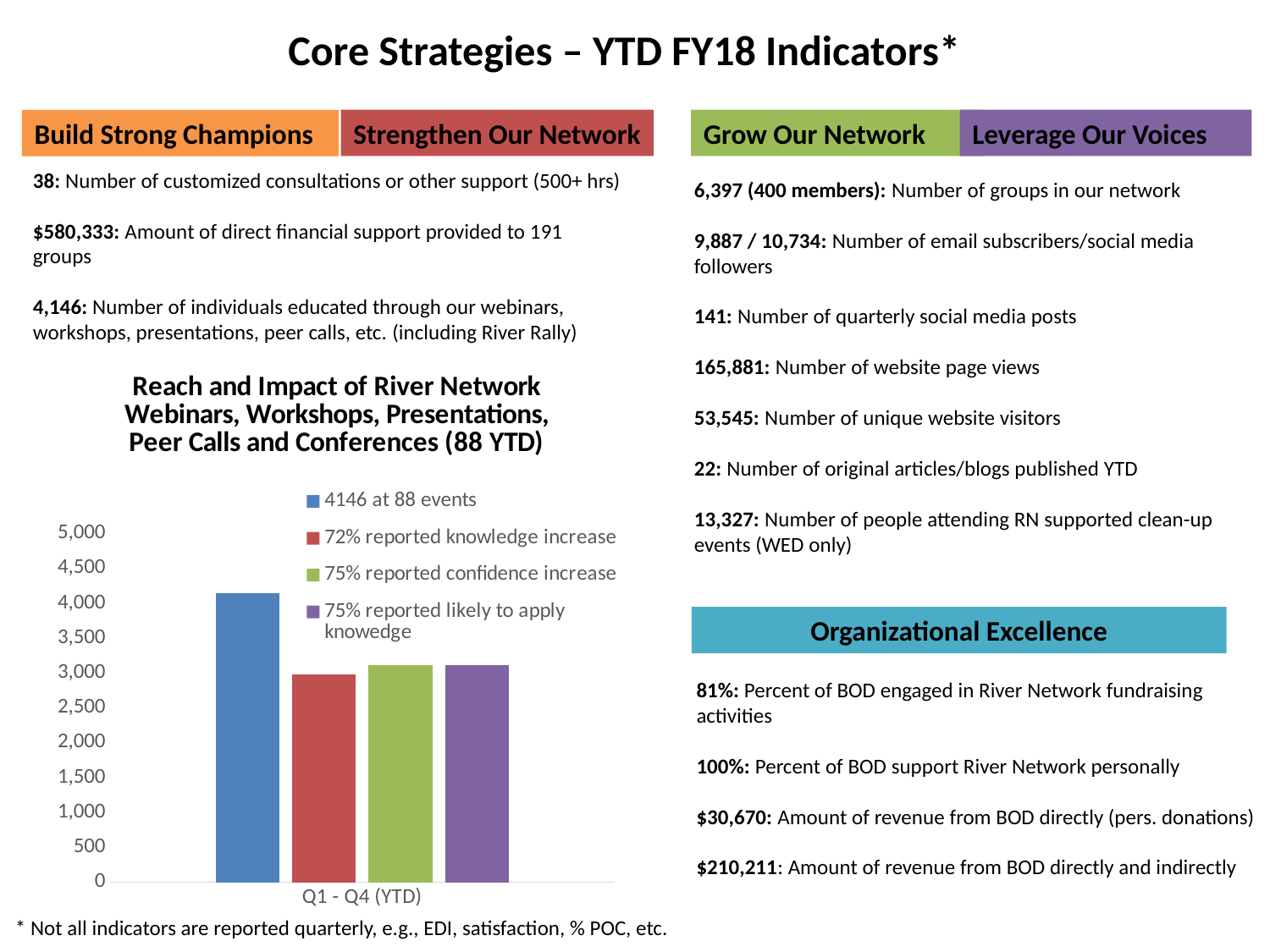
Which bar is taller: '4146 at 88 events' or '72% reported knowledge increase'? 4146 at 88 events Is the bar for '75% reported confidence increase' greater or less than 2,500? greater Is the bar for '4146 at 88 events' greater or less than 4,000? greater Is the bar for '75% reported likely to apply knowedge' greater or less than 4,000? less How many categories are shown on the x axis of the chart? 1 How many series does the chart legend list? 4 What is the highest value shown on the chart's vertical axis? 5,000 Which series has the tallest bar in the chart? 4146 at 88 events What is the label of the category on the x axis of the chart? Q1 - Q4 (YTD) What kind of chart is shown on the slide? bar chart